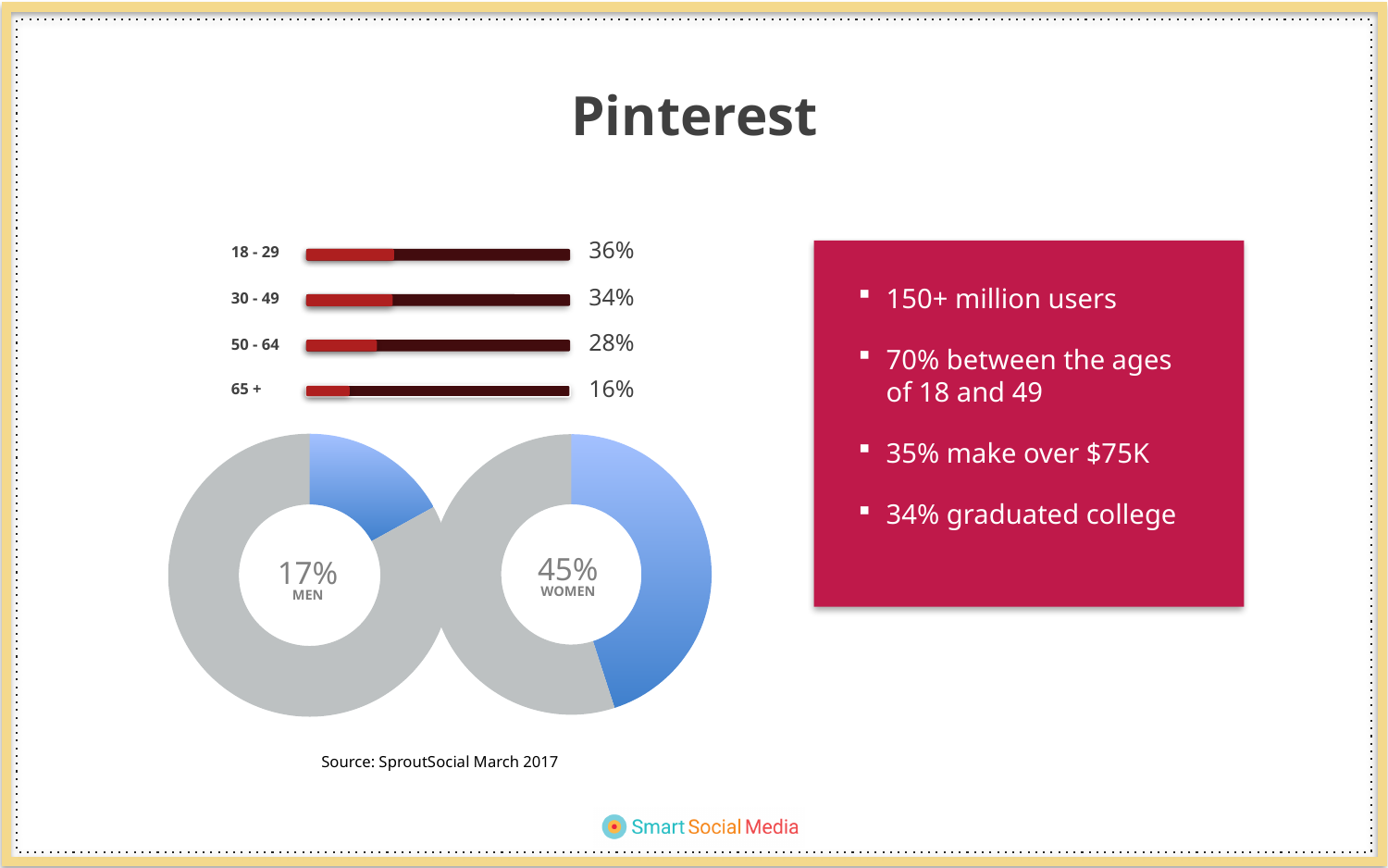
In the age-group bar chart, what is the value for the 18 - 29 group? 36% In the age-group bar chart, which age group has the lowest value? 65 + In the age-group bar chart, do the values rise or fall from the youngest to the oldest age group? Fall In the age-group bar chart, what is the value for the 65 + group? 16% In the age-group bar chart, which is larger, the value for 30 - 49 or for 50 - 64? 30 - 49 In the donut chart on the right, what percentage is shown for women? 45% What kind of chart is used to show the age groups? Bar chart In the donut chart on the left, what percentage is shown for men? 17% In the age-group bar chart, what is the value for the 50 - 64 group? 28% In the age-group bar chart, what is the difference between the 30 - 49 and 65 + values? 18% In the age-group bar chart, which age group has the highest value? 18 - 29 How many age groups are shown in the age-group bar chart? 4